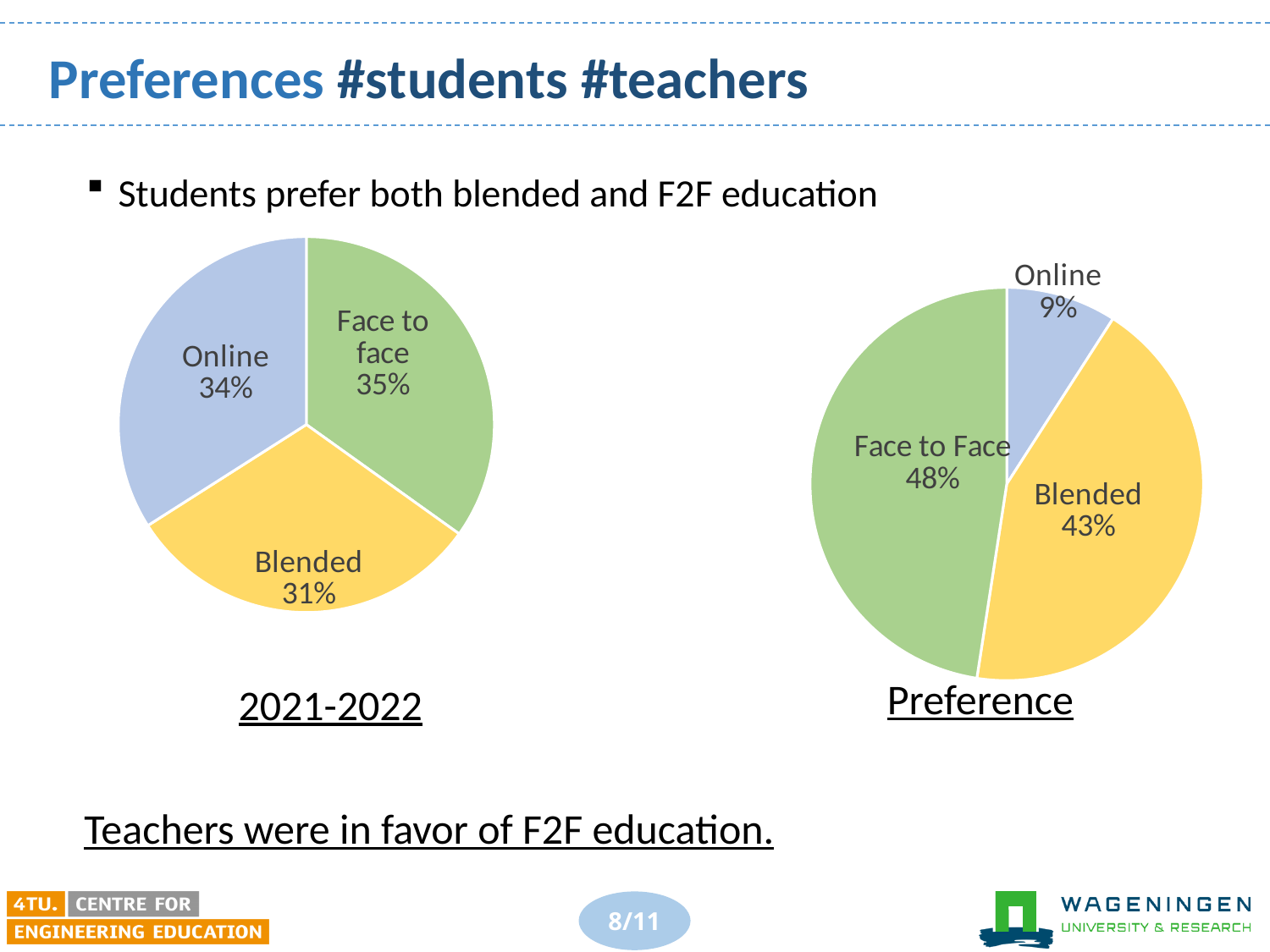
In the right pie chart labelled Preference, which category has the smallest share? Online In the left pie chart labelled 2021-2022, what share is Blended? 31% In the right pie chart labelled Preference, which is larger, Blended or Online? Blended What type of chart is the chart labelled Preference on the right? Pie chart In the right pie chart labelled Preference, which category has the largest share? Face to Face In the right pie chart labelled Preference, what share is Online? 9% In the left pie chart labelled 2021-2022, which category has the smallest share? Blended In the right pie chart labelled Preference, what is the difference between the Face to Face and Blended shares? 5% In the left pie chart labelled 2021-2022, what share is Online? 34% In the right pie chart labelled Preference, what share is Face to Face? 48% In the left pie chart labelled 2021-2022, what is the difference between the Face to face and Blended shares? 4% How many slices does the left pie chart labelled 2021-2022 have? 3